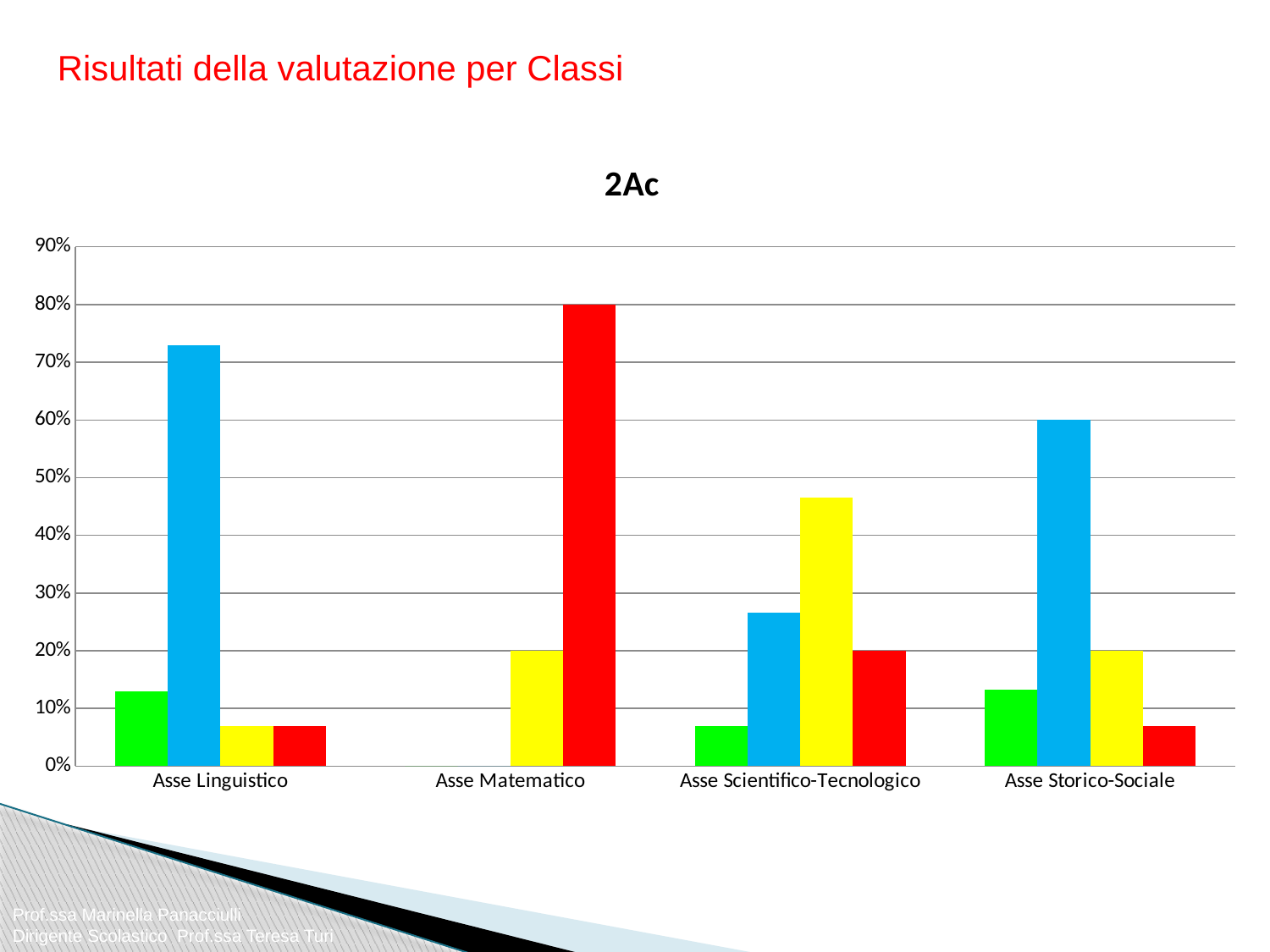
Which category has the tallest bar in the chart? Asse Matematico Is the value of the yellow bar for Asse Scientifico-Tecnologico greater or less than 40%? greater What is the difference between the red bar and the yellow bar for Asse Matematico? 60% Is the value of the blue bar for Asse Linguistico greater or less than 70%? greater How many categories are shown on the x axis of the chart? 4 What is the value of the blue bar for Asse Storico-Sociale? 60% What is the value of the red bar for Asse Scientifico-Tecnologico? 20% What is the title of the chart? 2Ac What is the value of the red bar for Asse Matematico? 80% What kind of chart is shown on the slide? bar chart Which is larger for Asse Scientifico-Tecnologico, the blue bar or the yellow bar? the yellow bar What is the value of the yellow bar for Asse Matematico? 20%